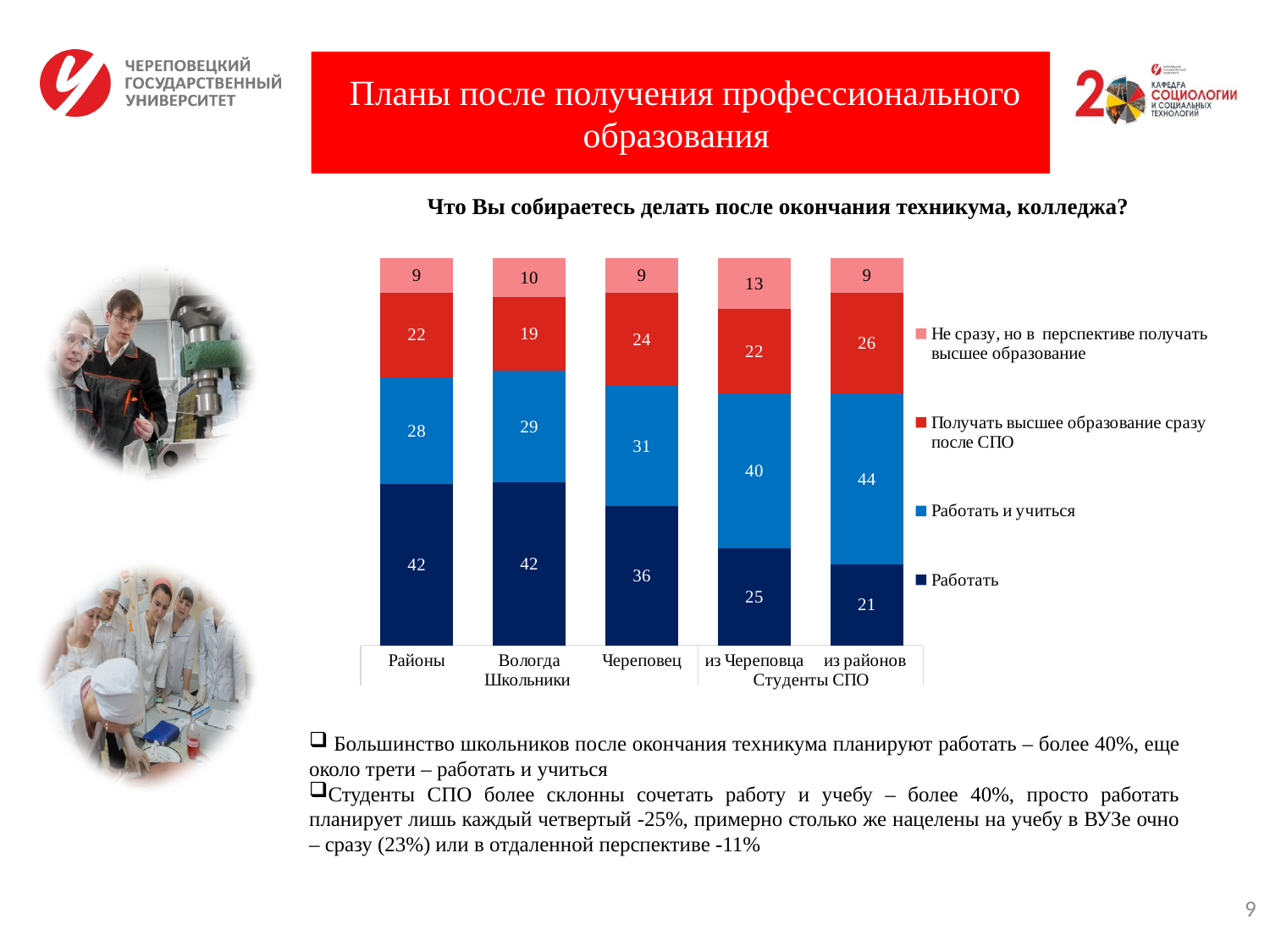
What is the difference between the "Работать" values for "Вологда" and "Череповец"? 6 What kind of chart is shown on the slide? Stacked bar chart What is the total of the stacked bar for "Вологда"? 100 What is the value of "Получать высшее образование сразу после СПО" for "Череповец"? 24 What is the value of "Работать и учиться" for "из районов"? 44 What is the value of "Не сразу, но в перспективе получать высшее образование" for "из Череповца"? 13 How many categories (bars) are shown on the x axis? 5 Which category has the highest value for "Работать и учиться"? из районов How many series does the legend list? 4 What is the value of "Работать" for "Районы"? 42 Which is larger: the "Работать и учиться" value for "из Череповца" or for "Череповец"? из Череповца Which category has the lowest value for "Работать"? из районов